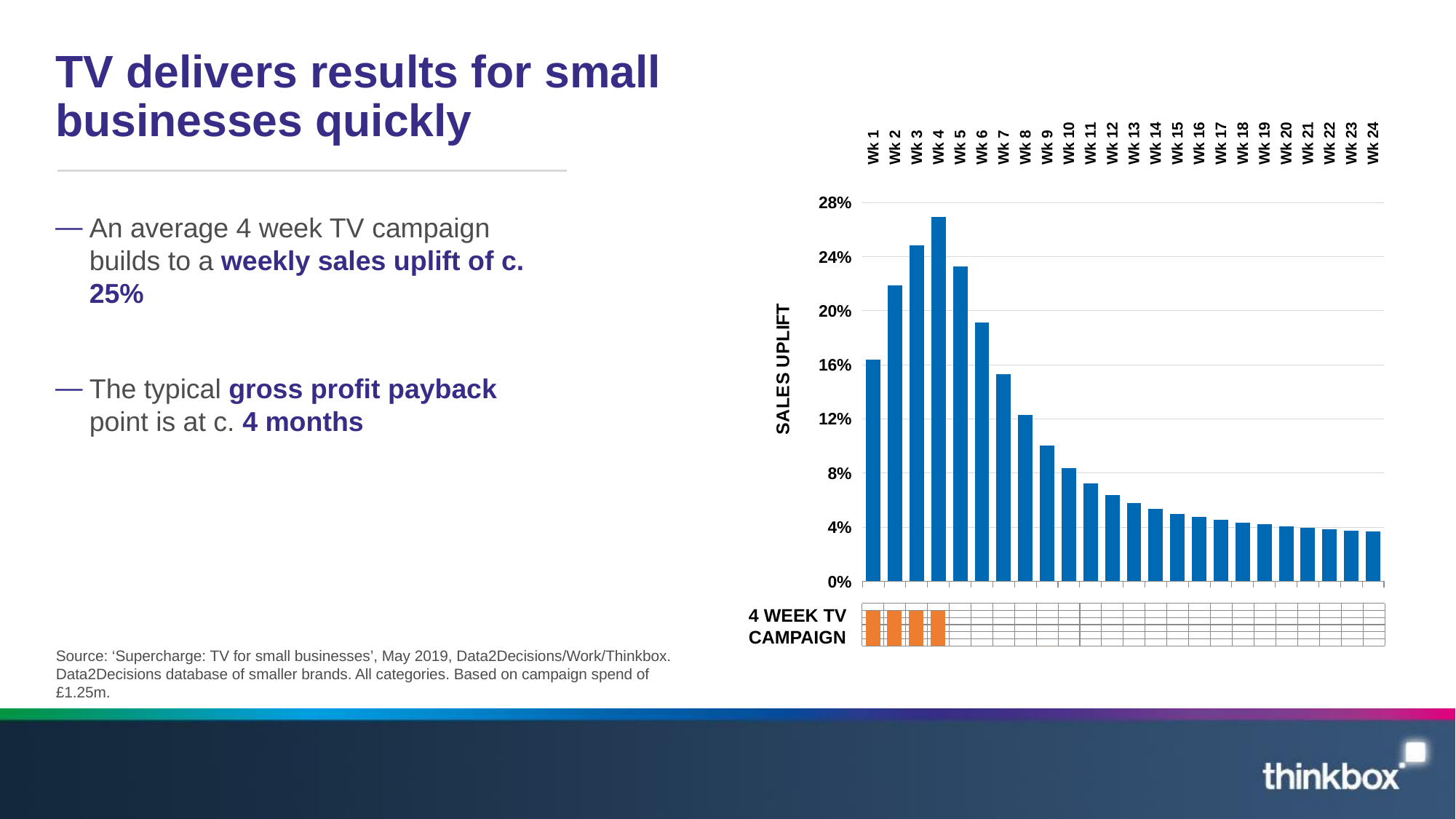
Which week has the highest sales uplift? Wk 4 How many weeks are plotted on the x axis of the chart? 24 Is the sales uplift for Wk 4 greater or less than 24%? greater Is the sales uplift for Wk 6 greater or less than 16%? greater Which has a higher sales uplift, Wk 2 or Wk 7? Wk 2 Is the sales uplift for Wk 9 greater or less than 8%? greater Which has a higher sales uplift, Wk 3 or Wk 5? Wk 3 Do the sales uplift values rise or fall from Wk 4 to Wk 24? fall What kind of chart is shown on the slide? bar chart What is the label on the vertical axis of the chart? SALES UPLIFT